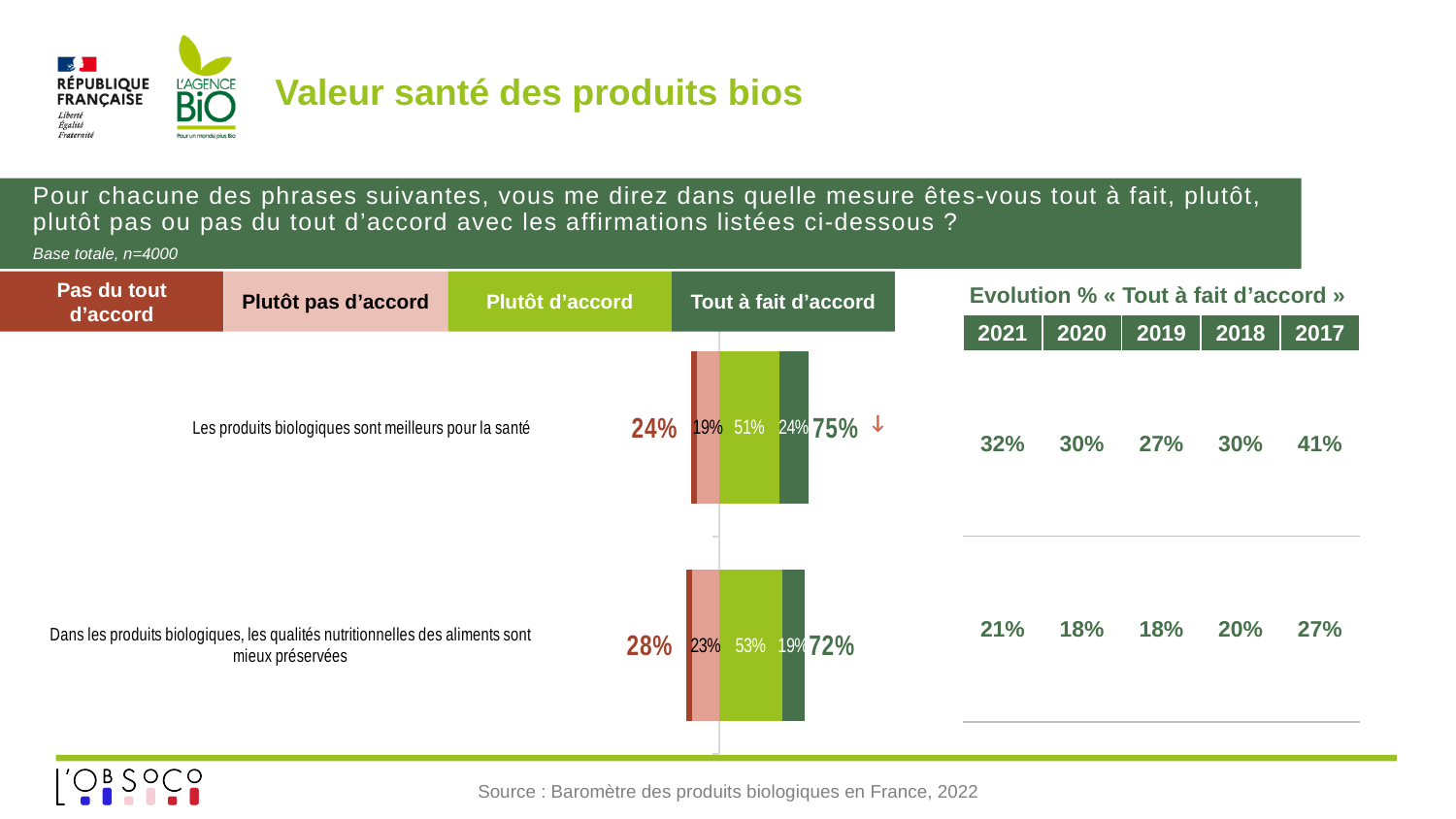
What colour represents 'Tout à fait d'accord' in the legend? dark green What type of chart is used to show the agreement levels for the two statements? stacked bar chart What is the 'Plutôt d'accord' value for the statement 'Les produits biologiques sont meilleurs pour la santé'? 51% What is the difference between the 'Plutôt d'accord' values of the two statements? 2 points Which statement has the higher 'Tout à fait d'accord' value in the bar chart? Les produits biologiques sont meilleurs pour la santé In the 'Evolution % « Tout à fait d'accord »' table, which year has the lowest value for 'Dans les produits biologiques, les qualités nutritionnelles des aliments sont mieux préservées'? 2020 and 2019 (18%) How many response categories does the legend above the bar chart list? 4 What is the total disagreement percentage shown for 'Dans les produits biologiques, les qualités nutritionnelles des aliments sont mieux préservées'? 28% What is the 'Tout à fait d'accord' value for the statement 'Dans les produits biologiques, les qualités nutritionnelles des aliments sont mieux préservées'? 19% How many statements (categories) are plotted in the bar chart? 2 What is the total agreement percentage shown for 'Les produits biologiques sont meilleurs pour la santé'? 75% In the 'Evolution % « Tout à fait d'accord »' table, what is the 2017 value for 'Les produits biologiques sont meilleurs pour la santé'? 41%